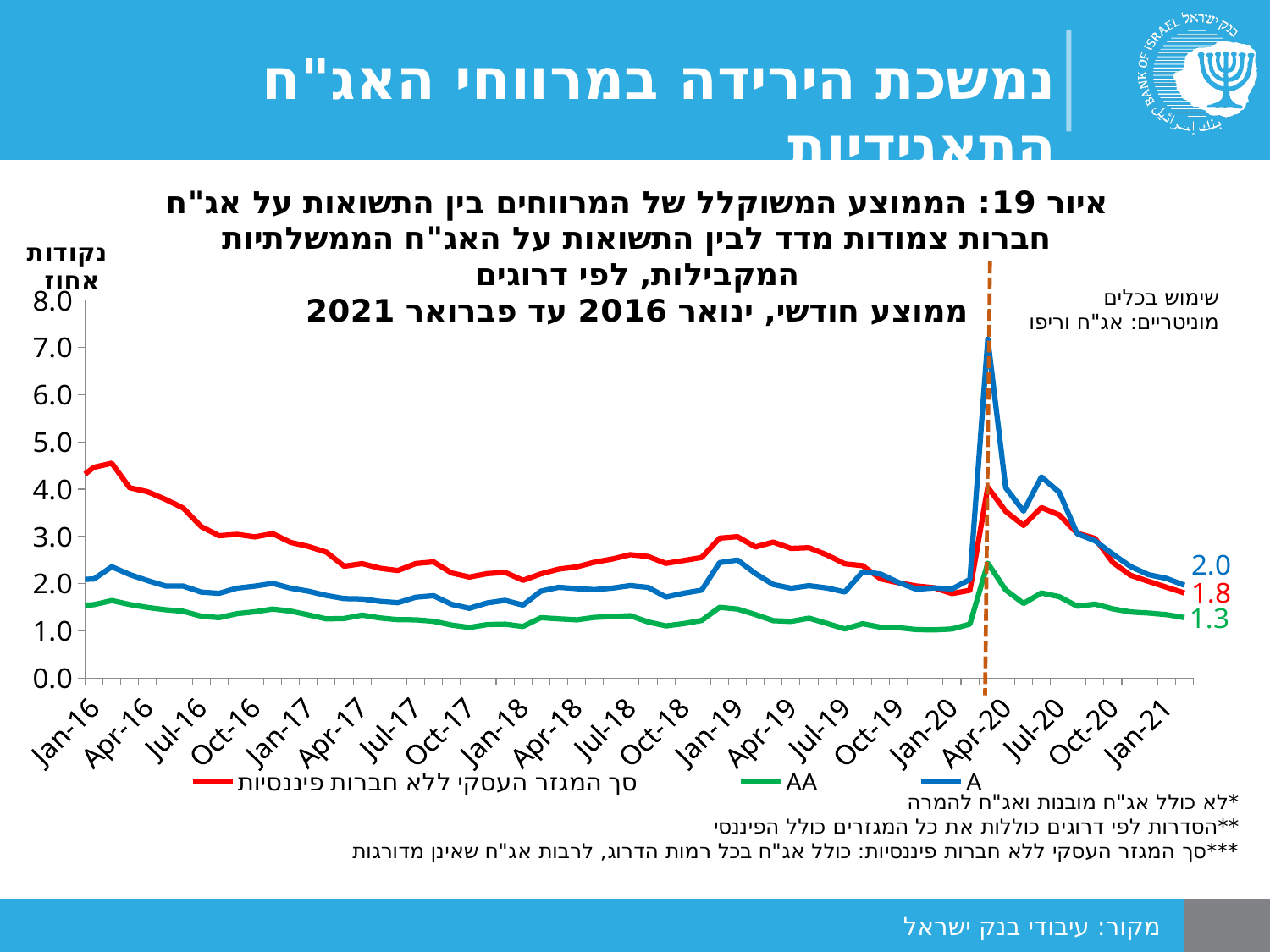
Is the value of the AA series at Jan-16 greater or less than 2.0? less What is the final value labelled at the end of the AA series? 1.3 What is the final value labelled at the end of the red series (סך המגזר העסקי ללא חברות פיננסיות)? 1.8 How many series does the legend list? 3 What is the difference between the final labelled values of the A series and the AA series? 0.7 What kind of chart is shown on the slide? line chart Which series has the lowest labelled value at the end of the chart? AA What colour is the line for the AA series? green What is the final value labelled at the end of the A series? 2.0 Which series has the highest labelled value at the end of the chart? A Is the peak value of the A series around Apr-20 greater or less than 6.0? greater Does the red series (סך המגזר העסקי ללא חברות פיננסיות) overall rise or fall from Jan-16 to Jan-21? fall